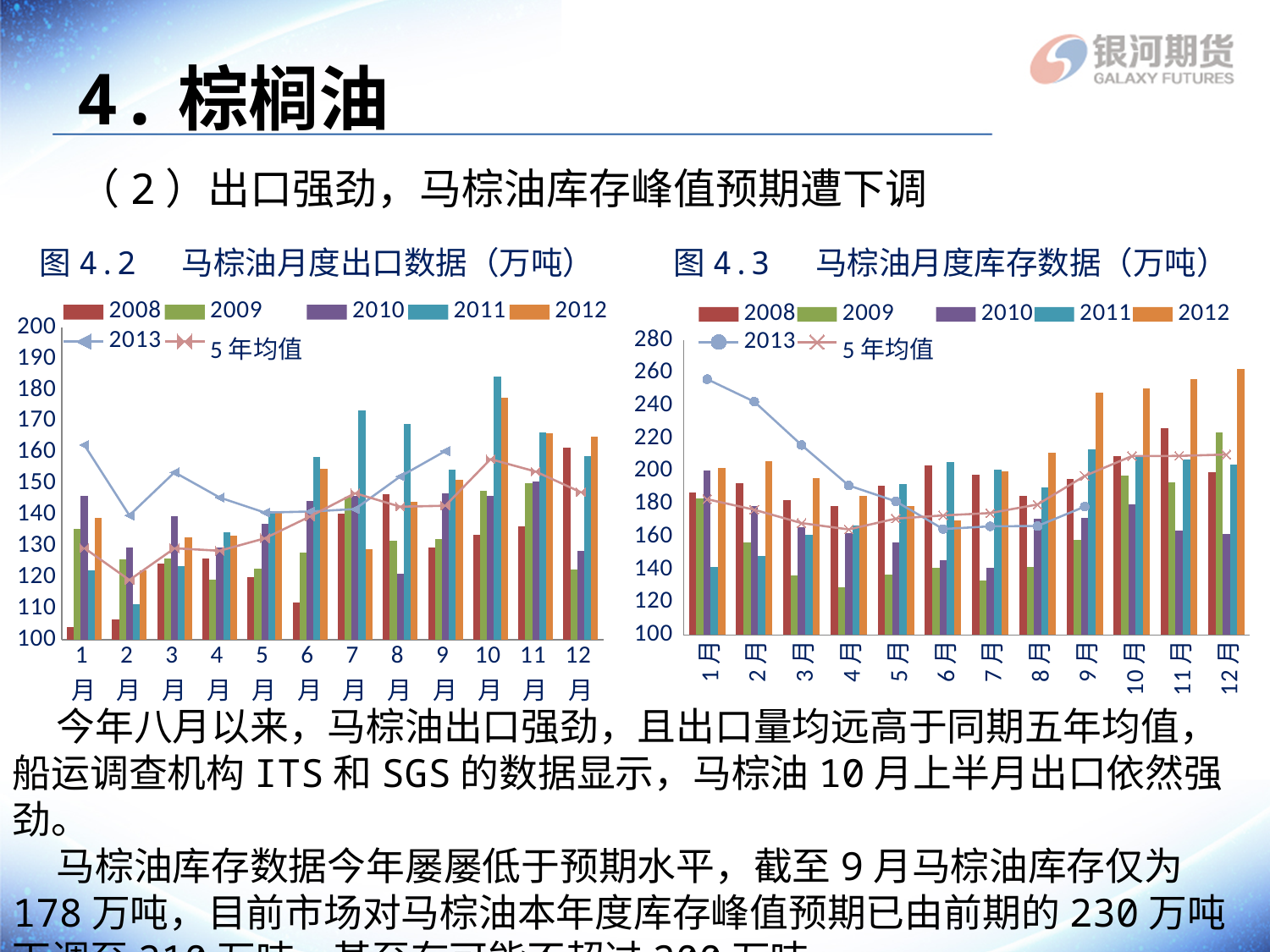
How many series does the legend of 图4.3 马棕油月度库存数据 list? 7 In 图4.2 马棕油月度出口数据, is the 2013 value for 1月 greater or less than 150? greater In 图4.3 马棕油月度库存数据, which is larger: the 2013 value for 1月 or the 2013 value for 9月? 1月 In 图4.3 马棕油月度库存数据, is the 2012 value for 12月 greater or less than 240? greater In 图4.3 马棕油月度库存数据, does the 2013 line rise or fall from 1月 to 6月? fall What kind of chart is 图4.3 马棕油月度库存数据? Combined bar and line chart How many months are shown on the x axis of 图4.2 马棕油月度出口数据? 12 How many series does the legend of 图4.2 马棕油月度出口数据 list? 7 In 图4.2 马棕油月度出口数据, is the 5年均值 value for 2月 greater or less than 130? less What is the title of the chart on the left of the slide? 图4.2 马棕油月度出口数据（万吨）